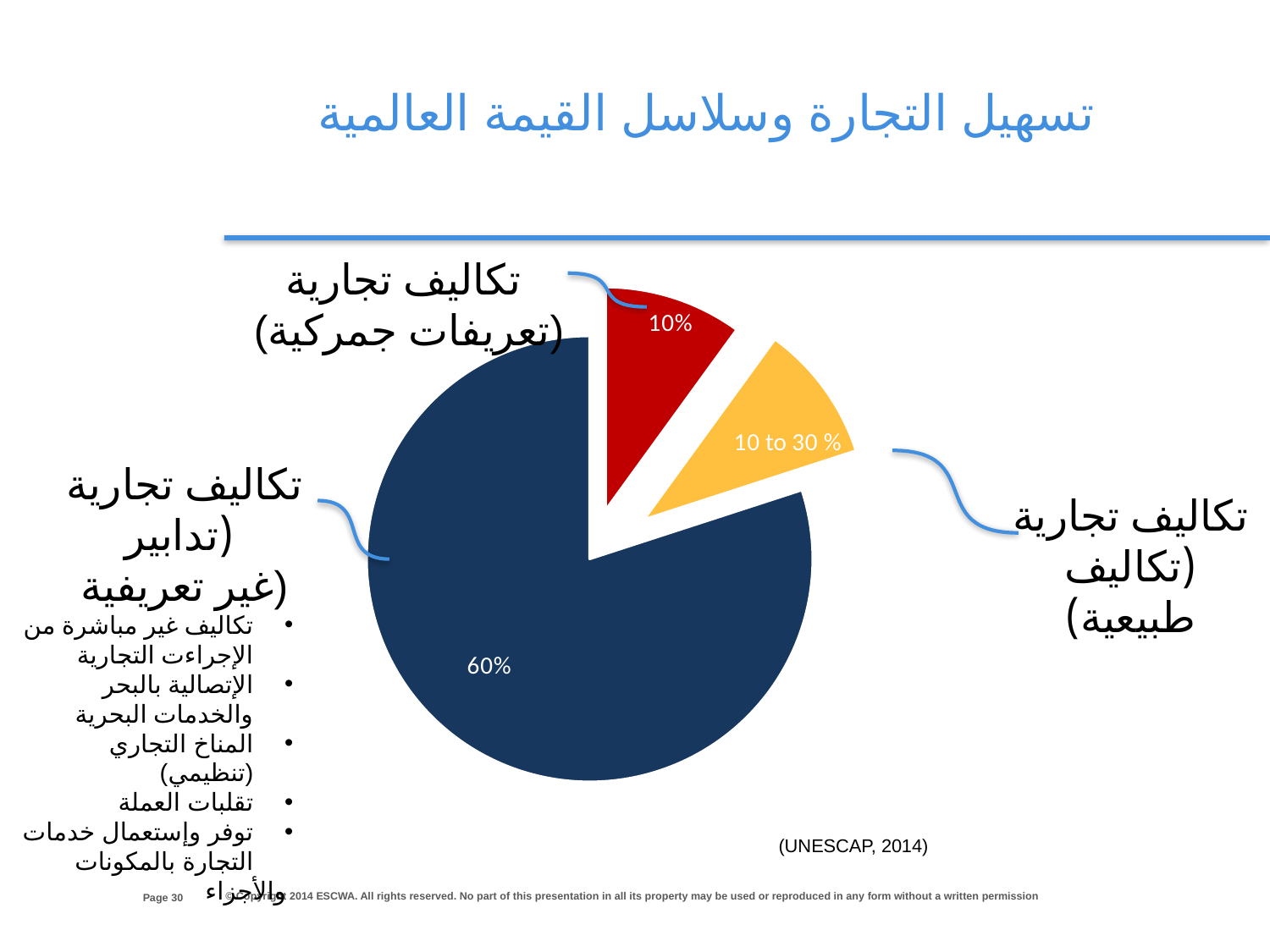
What value is shown on the yellow slice labelled تكاليف تجارية (تكاليف طبيعية)? 10 to 30 % What type of chart is shown on the slide? pie chart Which slice of the pie chart is the largest? تكاليف تجارية (تدابير غير تعريفية) What share of the pie does the slice for تكاليف تجارية (تعريفات جمركية) represent? 10% Which is larger: the slice for تعريفات جمركية or the slice for تدابير غير تعريفية? تدابير غير تعريفية What colour is the slice labelled 60%? dark blue What is the difference between the 60% slice and the 10% slice? 50% How many slices does the pie chart have? 3 What value is shown on the dark blue slice labelled تكاليف تجارية (تدابير غير تعريفية)? 60% What value is shown on the red slice labelled تكاليف تجارية (تعريفات جمركية)? 10% What source is cited below the pie chart? (UNESCAP, 2014)